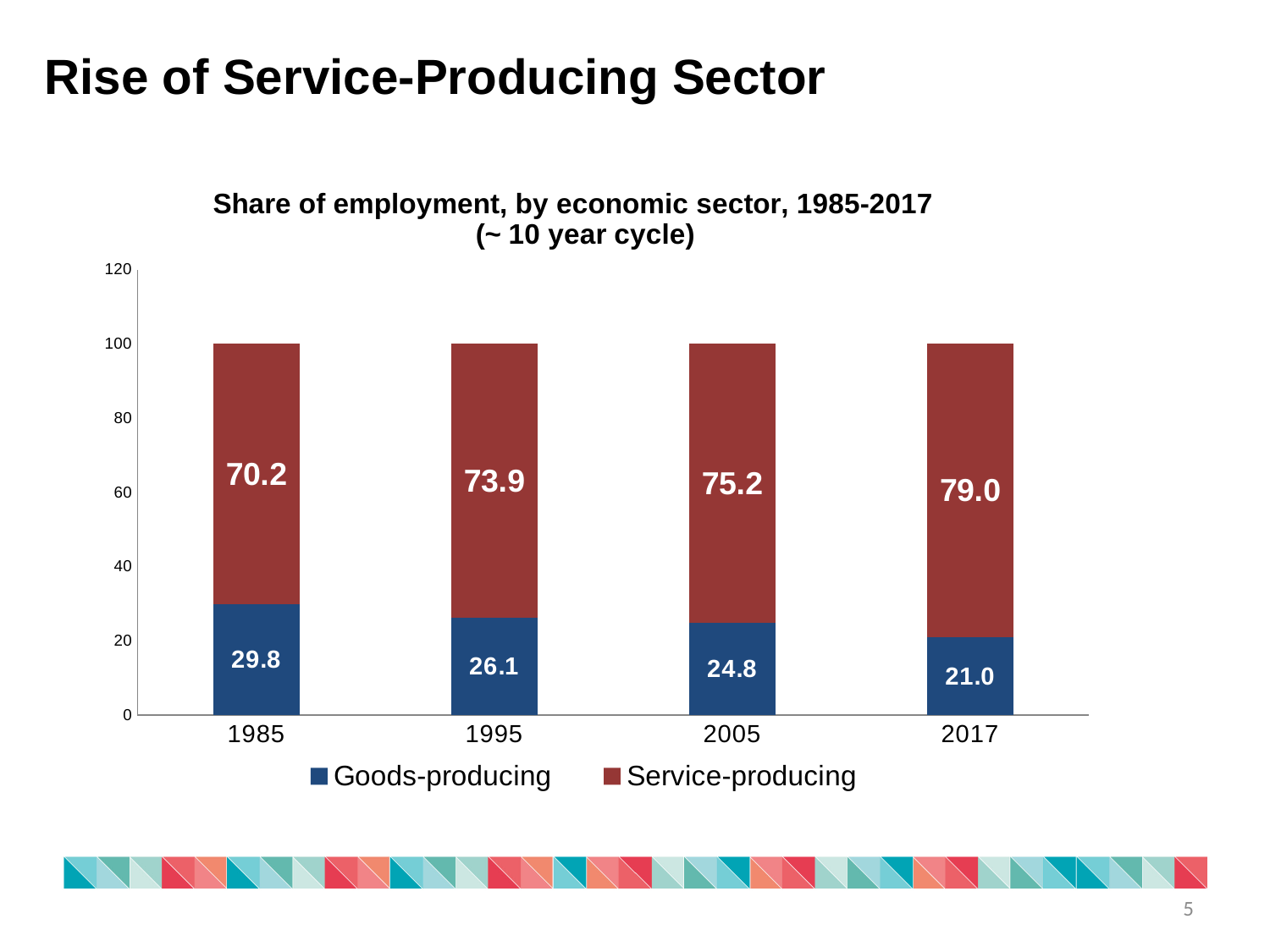
What is the difference between the Service-producing share in 2017 and in 1985? 8.8 Which is larger in 1995: the Goods-producing share or the Service-producing share? Service-producing How many series does the legend list? 2 What is the Goods-producing value for 2005? 24.8 What is the Service-producing share of employment in 2017? 79.0 In which year is the Goods-producing share lowest? 2017 How many years are shown on the x axis? 4 What is the Goods-producing share of employment in 1985? 29.8 Does the Goods-producing share rise or fall from 1985 to 2017? Fall In which year is the Service-producing share highest? 2017 What is the total of the stacked bar for 2005? 100.0 What kind of chart is shown on the slide? Stacked bar chart